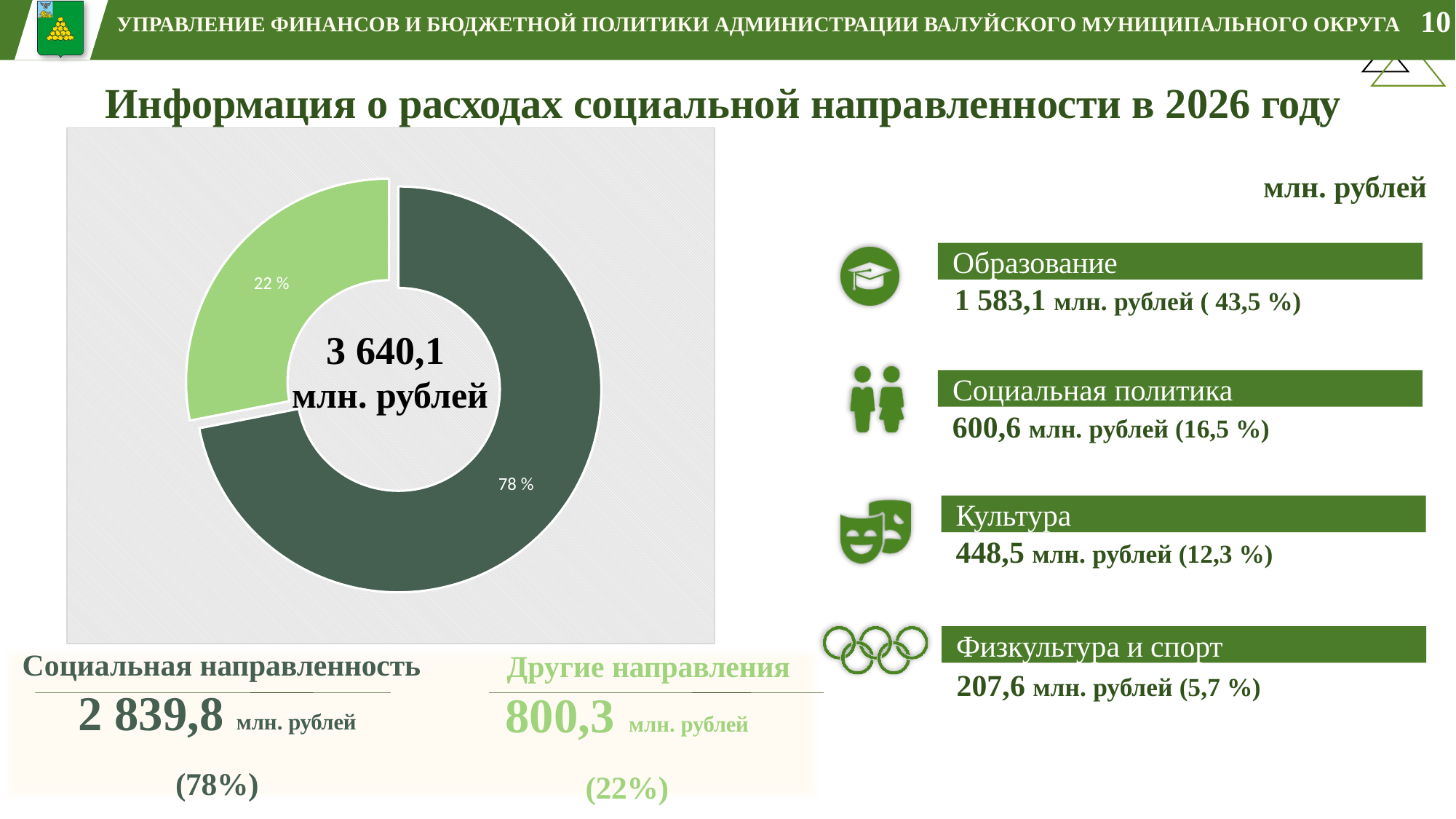
What kind of chart is shown on the slide? pie chart (donut) How many slices does the pie chart have? 2 What is the difference between the values for Социальная направленность and Другие направления? 2 039,5 млн. рублей What colour is the 78 % slice of the pie chart? dark green What is the value for Другие направления? 800,3 млн. рублей What is the value for Социальная направленность? 2 839,8 млн. рублей What total value is shown in the centre of the pie chart? 3 640,1 млн. рублей Which slice of the pie chart is the smallest? Другие направления What share of the pie chart does Социальная направленность take? 78 % Which slice of the pie chart is the largest? Социальная направленность Which is larger, Социальная направленность or Другие направления? Социальная направленность What share of the pie chart does Другие направления take? 22 %